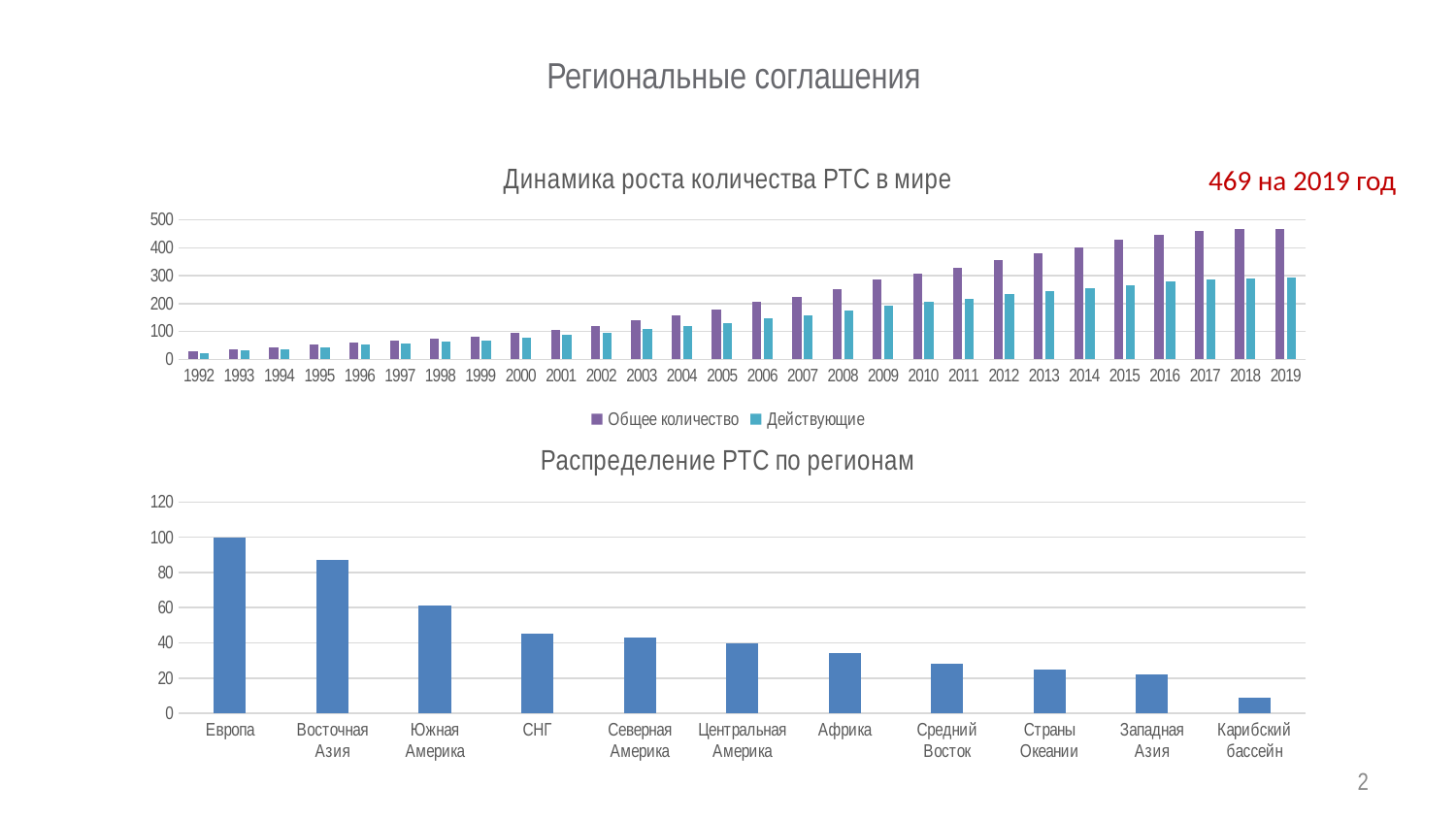
In the 'Распределение РТС по регионам' chart, how many regions are shown? 11 In the 'Динамика роста количества РТС в мире' chart, is the value for Действующие in 2019 greater or less than 200? greater In the 'Распределение РТС по регионам' chart, which region has the lowest value? Карибский бассейн In the 'Динамика роста количества РТС в мире' chart, is the value for Общее количество in 2005 greater or less than 200? less According to the slide, what is the total number of РТС (Общее количество) in 2019? 469 How many series does the legend of the 'Динамика роста количества РТС в мире' chart list? 2 What kind of chart is the 'Динамика роста количества РТС в мире' chart? bar chart In the 'Динамика роста количества РТС в мире' chart, what are the two legend entries? Общее количество, Действующие In the 'Распределение РТС по регионам' chart, which is larger: the value for Южная Америка or the value for СНГ? Южная Америка In the 'Распределение РТС по регионам' chart, which region has the highest value? Европа In the 'Динамика роста количества РТС в мире' chart, do the values for Общее количество rise or fall from 1992 to 2019? rise In the 'Динамика роста количества РТС в мире' chart, how many years are shown on the x axis? 28